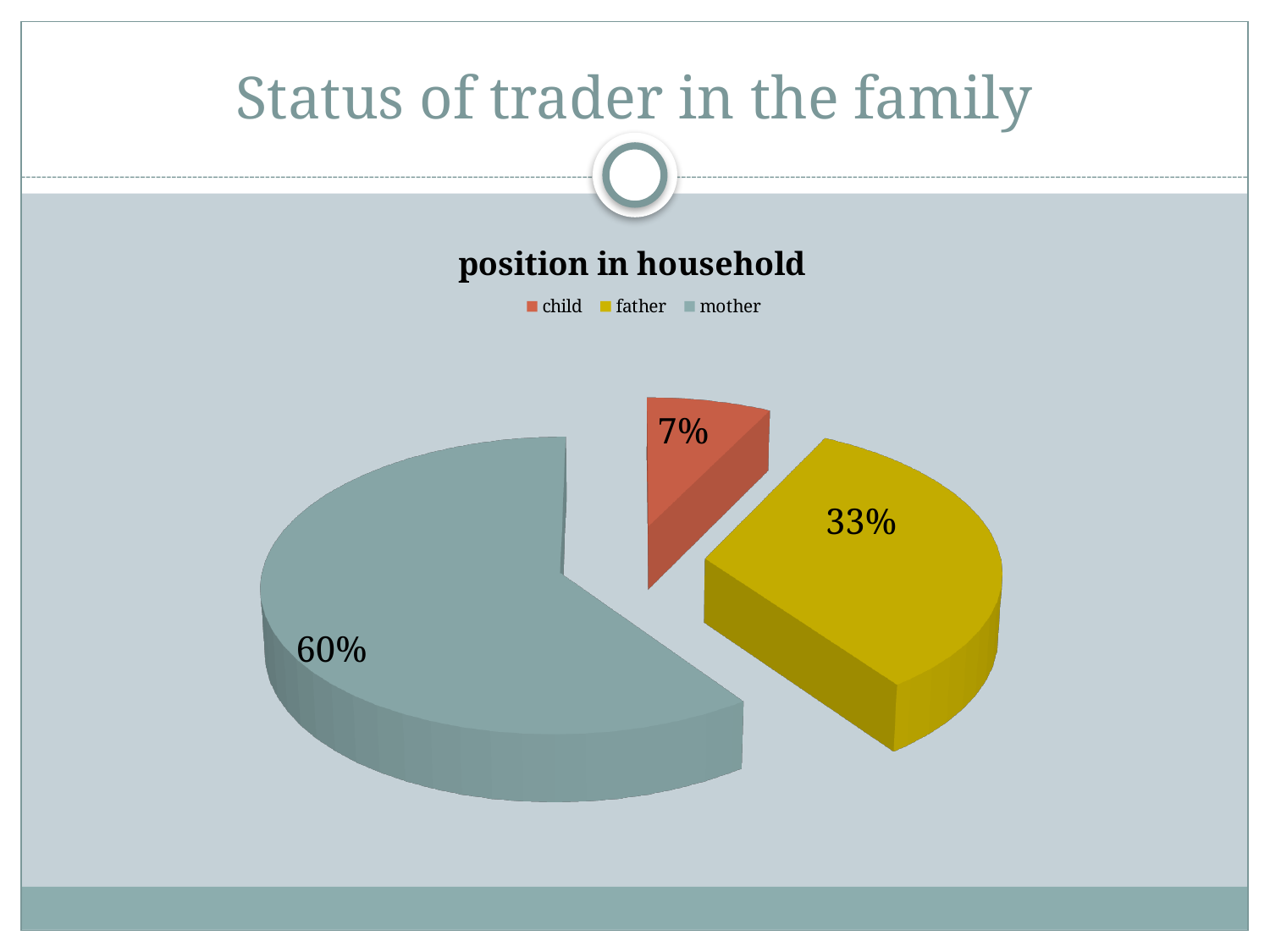
How many categories does the legend list? 3 What is the title of the chart? position in household What is the difference in percentage points between the father and child slices? 26 Which is larger, the share for father or the share for child? father What type of chart is shown on the slide? pie chart Which category has the smallest share of the pie? child What is the difference in percentage points between the mother and father slices? 27 What percentage of the pie is labelled for mother? 60% What percentage of the pie is labelled for father? 33% What percentage of the pie is labelled for child? 7% What colour is the slice for father? yellow Which category has the largest share of the pie? mother